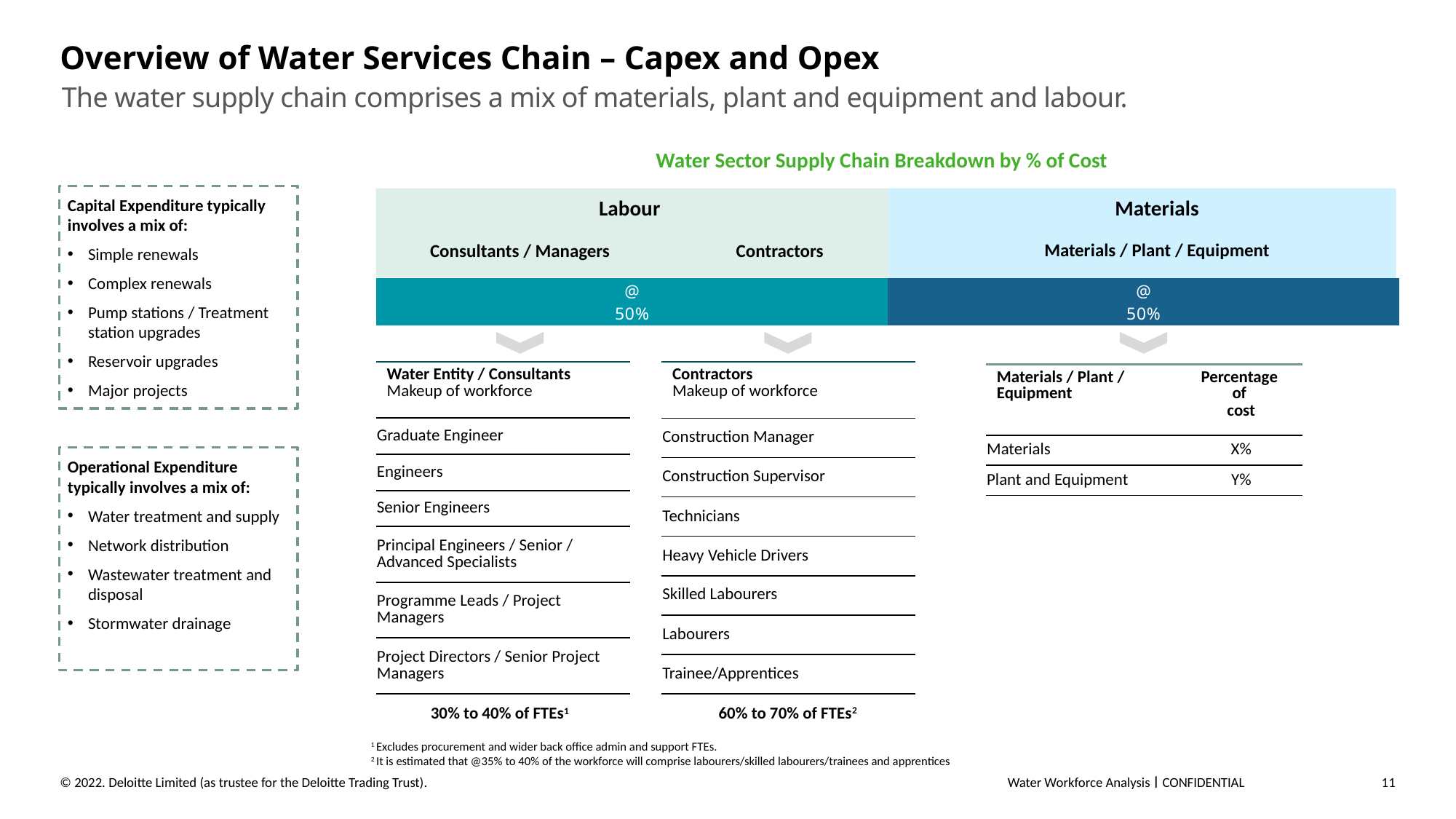
How many roles are listed in the Contractors makeup of workforce table? 7 How many roles are listed in the Water Entity / Consultants makeup of workforce table? 6 In the Water Sector Supply Chain Breakdown by % of Cost, what share of cost is shown for Labour? @ 50% What is the title of the breakdown graphic shown in green above the Labour and Materials bar? Water Sector Supply Chain Breakdown by % of Cost How many top-level segments does the Water Sector Supply Chain Breakdown bar divide cost into? 2 What percentage of cost is shown for Materials in the Materials / Plant / Equipment table? X% What percentage of FTEs is shown for the Contractors workforce? 60% to 70% of FTEs What percentage of FTEs is shown for the Water Entity / Consultants workforce? 30% to 40% of FTEs Which two sub-categories are listed under Labour in the Water Sector Supply Chain Breakdown? Consultants / Managers and Contractors Which workforce group accounts for the larger share of FTEs, Water Entity / Consultants or Contractors? Contractors In the Water Sector Supply Chain Breakdown by % of Cost, what share of cost is shown for Materials? @ 50% What percentage of cost is shown for Plant and Equipment in the Materials / Plant / Equipment table? Y%